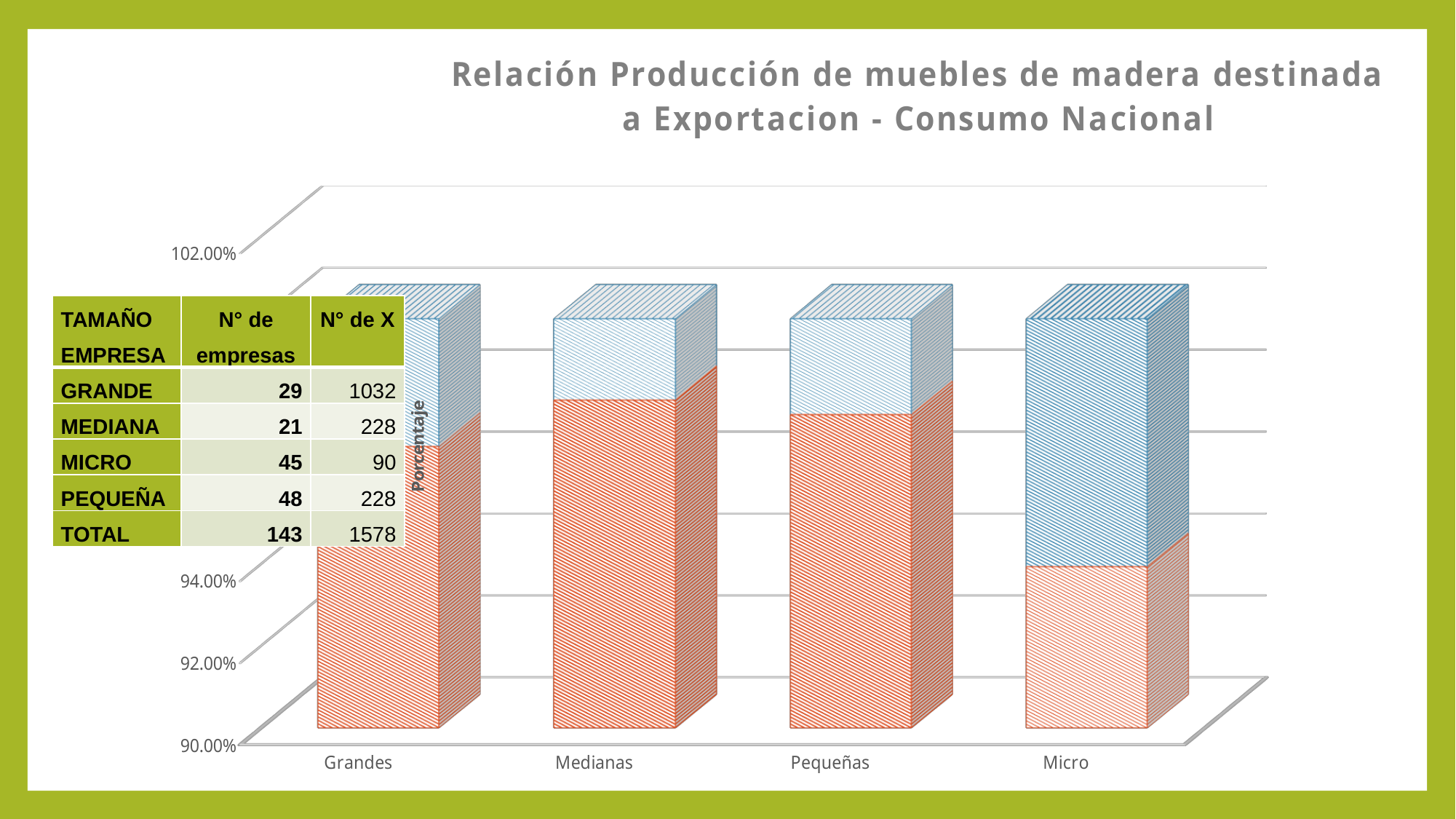
Is the red (bottom) segment larger for Grandes or for Micro? Grandes Is the top of the red segment for Grandes greater or less than 94.00%? greater Which category appears first (leftmost) on the x axis? Grandes What is the title of the chart? Relación Producción de muebles de madera destinada a Exportacion - Consumo Nacional How many categories are shown on the x axis of the chart? 4 What kind of chart is shown on the slide? Stacked bar chart Is the top of the red segment for Micro greater or less than 96.00%? less Which category has the largest blue (top) segment? Micro Is the blue (top) segment larger for Micro or for Grandes? Micro What is the lowest value shown on the vertical axis? 90.00% Which category has the smallest red (bottom) segment? Micro